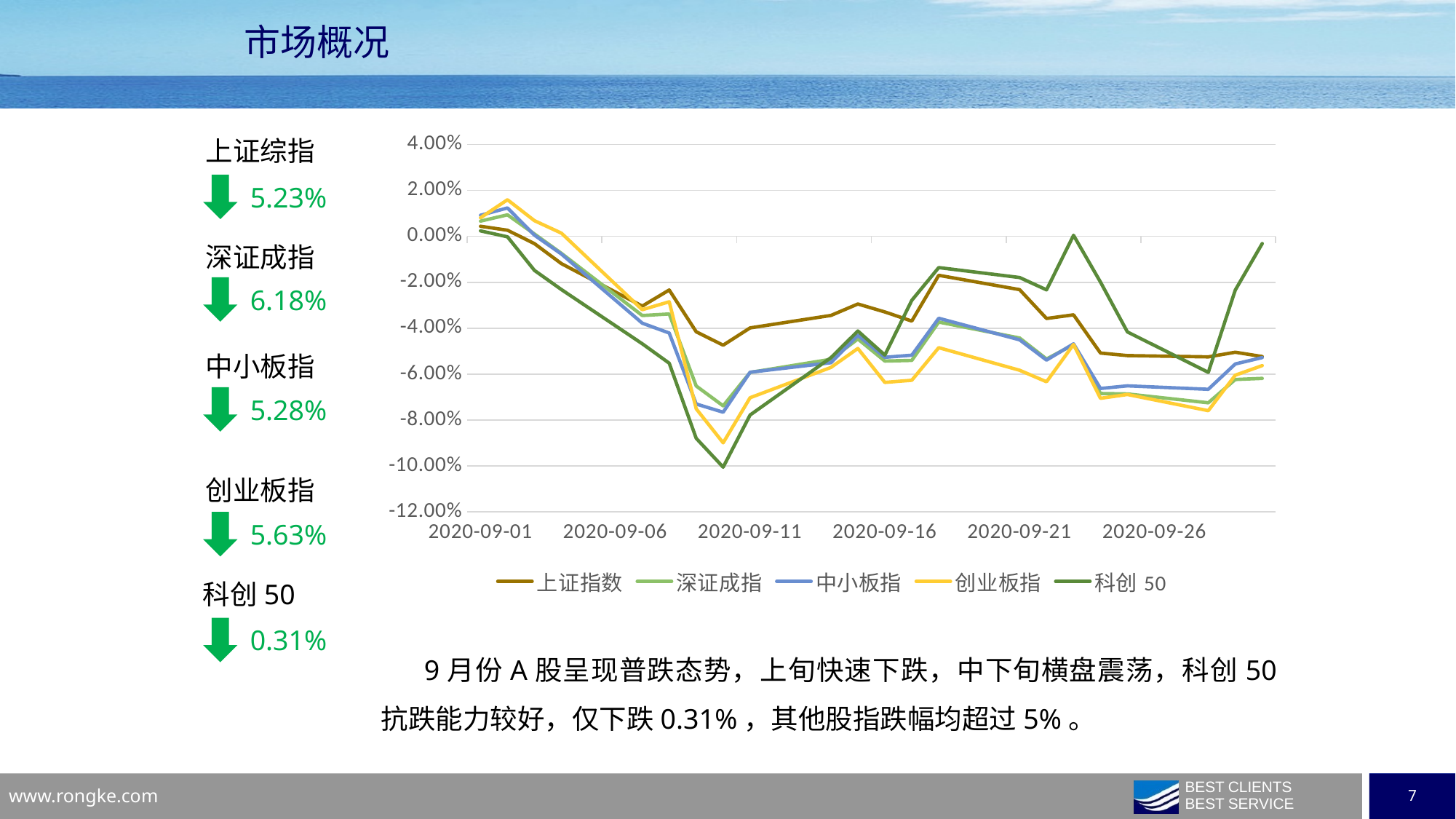
Is the value for 创业板指 at 2020-09-26 greater or less than -6.00%? less Which series has the highest value at the right end of the chart? 科创 50 What kind of chart is shown on the slide? line chart Do the values of the series rise or fall from 2020-09-01 to 2020-09-11? fall At 2020-09-21, which is larger: the value for 上证指数 or the value for 创业板指? 上证指数 What are the highest and lowest tick values shown on the chart's y axis? 4.00% and -12.00% How many date labels are shown on the x axis of the chart? 6 Is the lowest value of 科创 50 on the chart greater or less than -8.00%? less How many series does the chart's legend list? 5 Is the value for 上证指数 at 2020-09-11 greater or less than -6.00%? greater Which series reaches the lowest value anywhere on the chart? 科创 50 Which series are listed in the chart's legend? 上证指数, 深证成指, 中小板指, 创业板指, 科创 50